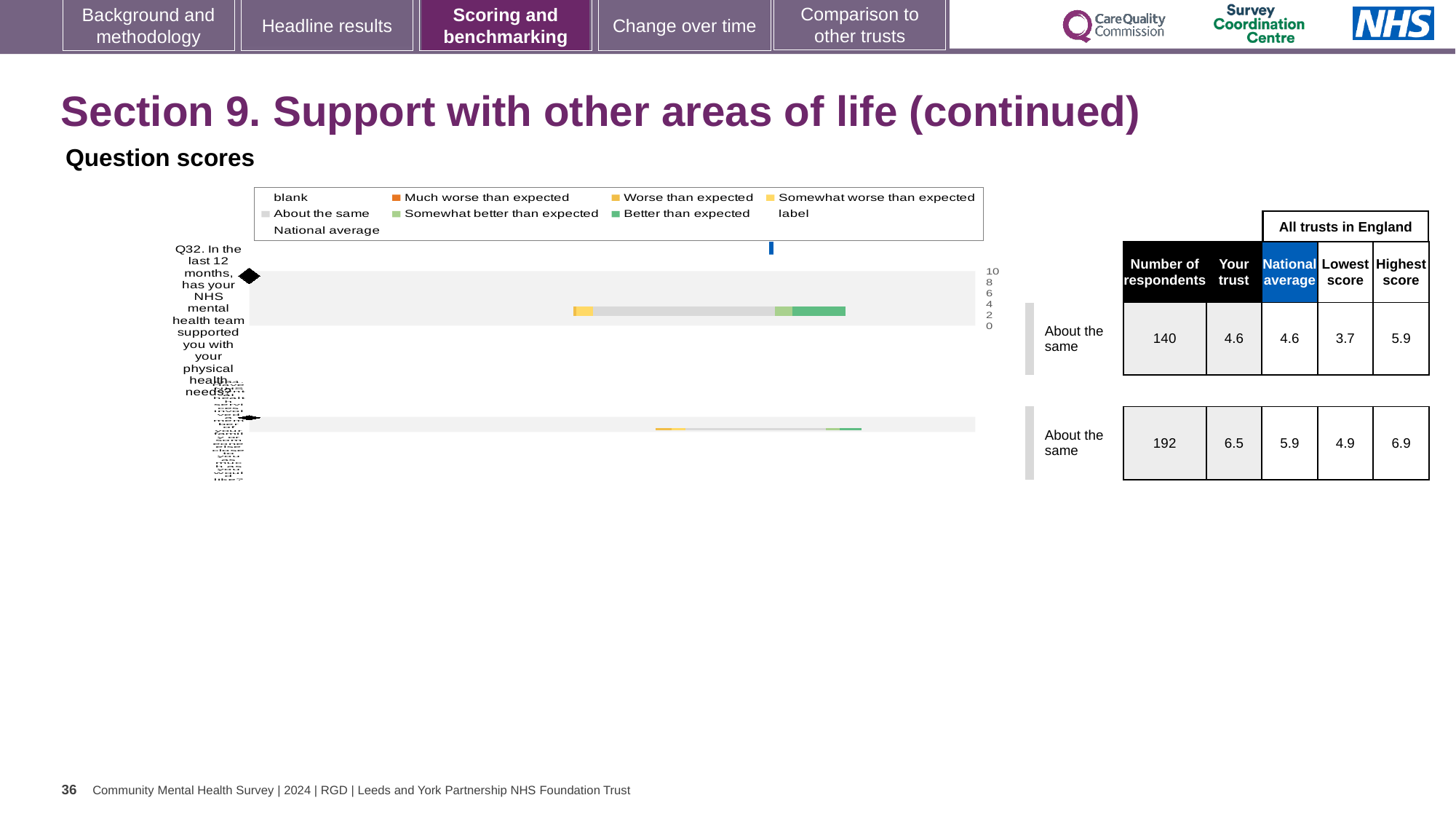
In the table, what is the national average for Q32? 4.6 In the table, what is the difference between the highest and lowest score for Q32? 2.2 In the table, what is the 'Your trust' score for the second question row? 6.5 In the table, is the 'Your trust' score for the second question row higher or lower than its national average? higher In the table, how many respondents are listed for Q32 (support with physical health needs)? 140 In the table, what is the highest score among all trusts in England for Q32? 5.9 What benchmark category is shown next to both question rows? About the same In the table, what is the lowest score among all trusts in England for Q32? 3.7 In the table, how many respondents are listed for the second question row? 192 In the table, what is the 'Your trust' score for Q32? 4.6 What kind of chart is shown on the slide? bar chart Which legend entry is shown in dark green? Better than expected